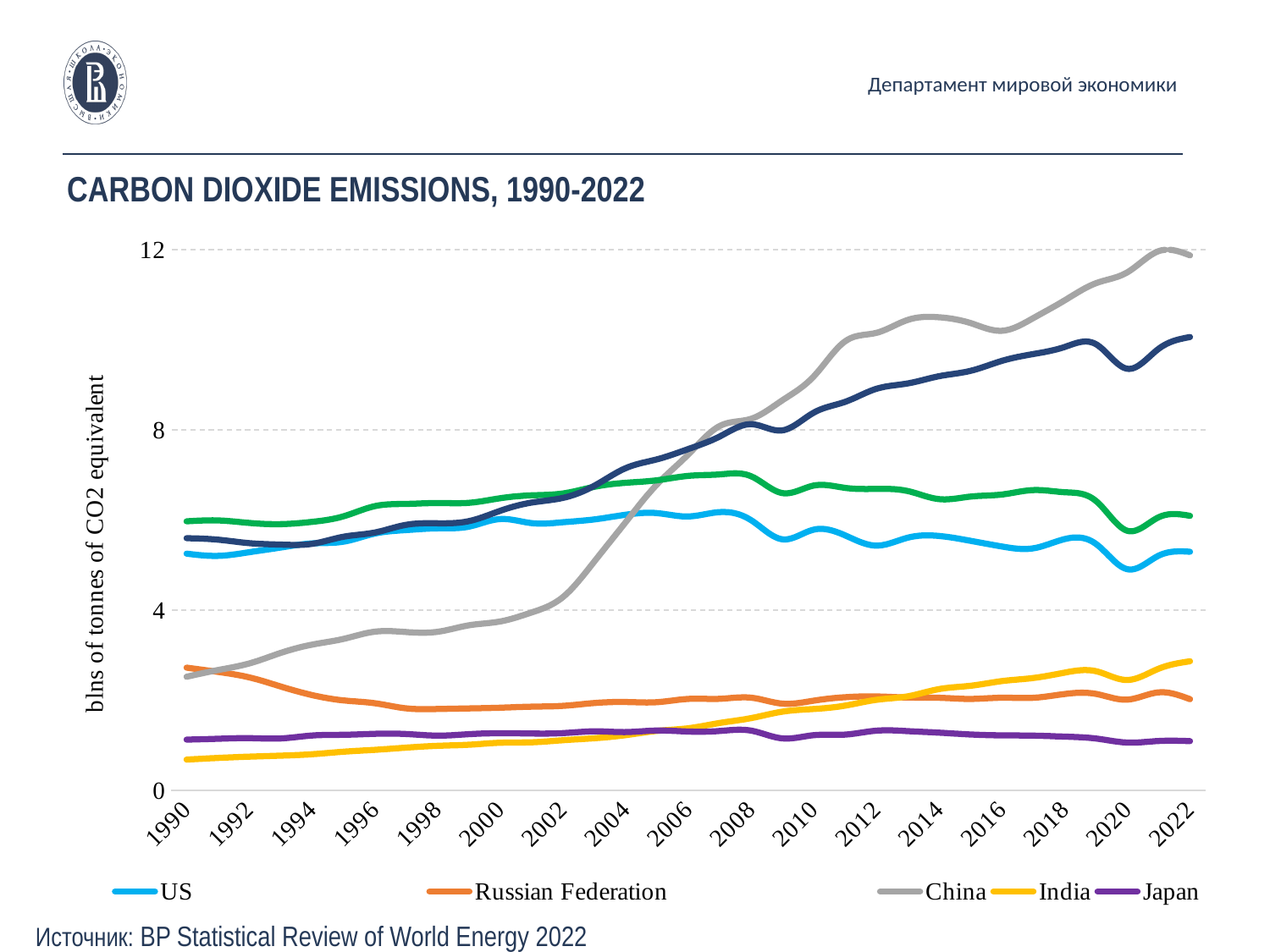
Is the value for India in 2022 greater or less than 4? less In 2022, which is larger, the value for India or the value for Japan? India Is the value for China in 2022 greater or less than 8? greater Is the value for China in 1990 greater or less than 4? less What is the title of the chart? CARBON DIOXIDE EMISSIONS, 1990-2022 How many series does the legend list? 5 What is the label on the vertical axis? blns of tonnes of CO2 equivalent Does the value for China rise or fall from 1990 to 2022? rise Which of the legend series has the highest value in 2022? China What kind of chart is shown on the slide? line chart Which of the legend series has the lowest value in 1990? India